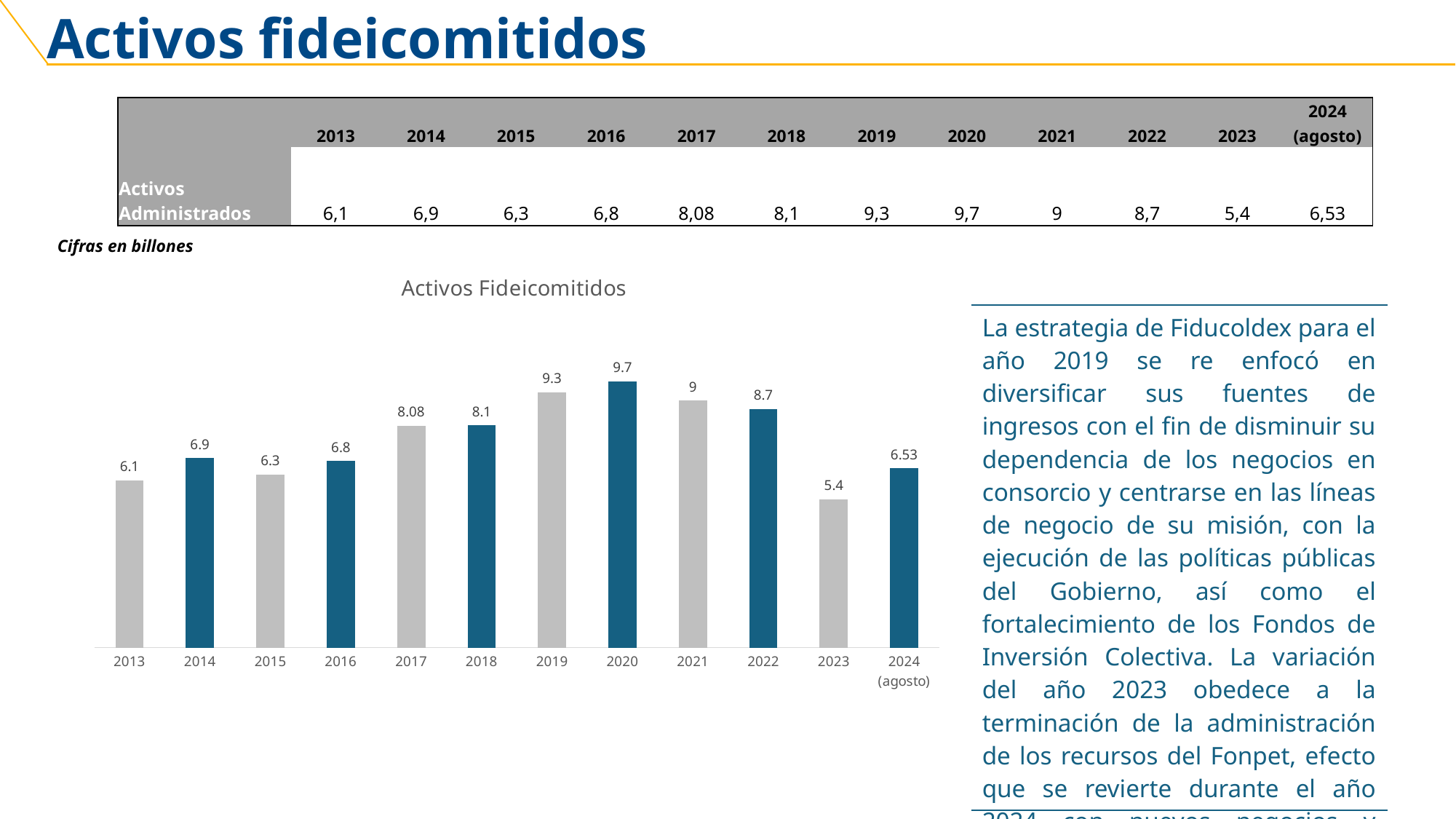
In the Activos Fideicomitidos chart, which is larger, the value for 2014 or the value for 2016? 2014 How many bars are plotted in the Activos Fideicomitidos chart? 12 What is the value for 2020 in the Activos Fideicomitidos chart? 9.7 Which year has the lowest value in the Activos Fideicomitidos chart? 2023 What kind of chart is the Activos Fideicomitidos chart? Bar chart What is the difference between the values for 2019 and 2013 in the Activos Fideicomitidos chart? 3.2 What is the difference between the values for 2020 and 2023 in the Activos Fideicomitidos chart? 4.3 In the Activos Fideicomitidos chart, do the values rise or fall from 2016 to 2020? Rise What is the value for 2017 in the Activos Fideicomitidos chart? 8.08 What is the value for 2024 (agosto) in the Activos Fideicomitidos chart? 6.53 What is the title of the chart on the slide? Activos Fideicomitidos Which year has the highest value in the Activos Fideicomitidos chart? 2020